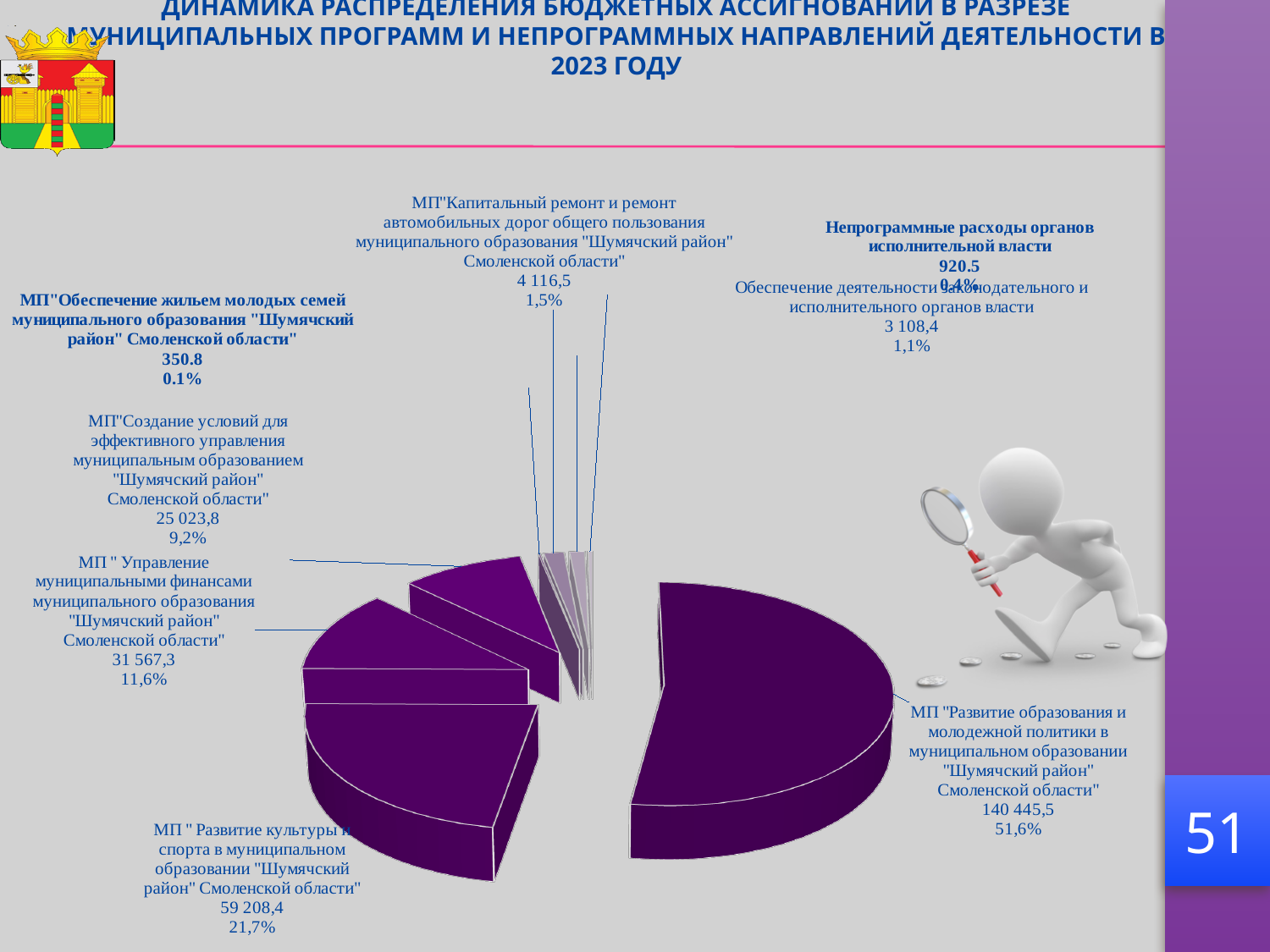
What is the value shown for МП "Развитие образования и молодежной политики в муниципальном образовании "Шумячский район" Смоленской области"? 140 445,5 How many slices does the pie chart have? 8 What kind of chart is shown on the slide? Pie chart What year does the chart title say the budget allocation data refers to? 2023 Which category has the smallest slice of the pie? МП "Обеспечение жильем молодых семей муниципального образования "Шумячский район" Смоленской области" What is the value shown for МП "Капитальный ремонт и ремонт автомобильных дорог общего пользования муниципального образования "Шумячский район" Смоленской области"? 4 116,5 Which is larger: the value for Обеспечение деятельности законодательного и исполнительного органов власти or the value for Непрограммные расходы органов исполнительной власти? Обеспечение деятельности законодательного и исполнительного органов власти What share of the pie does МП "Развитие культуры и спорта в муниципальном образовании "Шумячский район" Смоленской области" represent? 21,7% What is the value shown for МП "Управление муниципальными финансами муниципального образования "Шумячский район" Смоленской области"? 31 567,3 What is the difference between the values for МП "Развитие образования и молодежной политики" (140 445,5) and МП "Развитие культуры и спорта" (59 208,4)? 81 237,1 Which category has the largest slice of the pie? МП "Развитие образования и молодежной политики в муниципальном образовании "Шумячский район" Смоленской области" What percentage is shown for МП "Создание условий для эффективного управления муниципальным образованием "Шумячский район" Смоленской области"? 9,2%